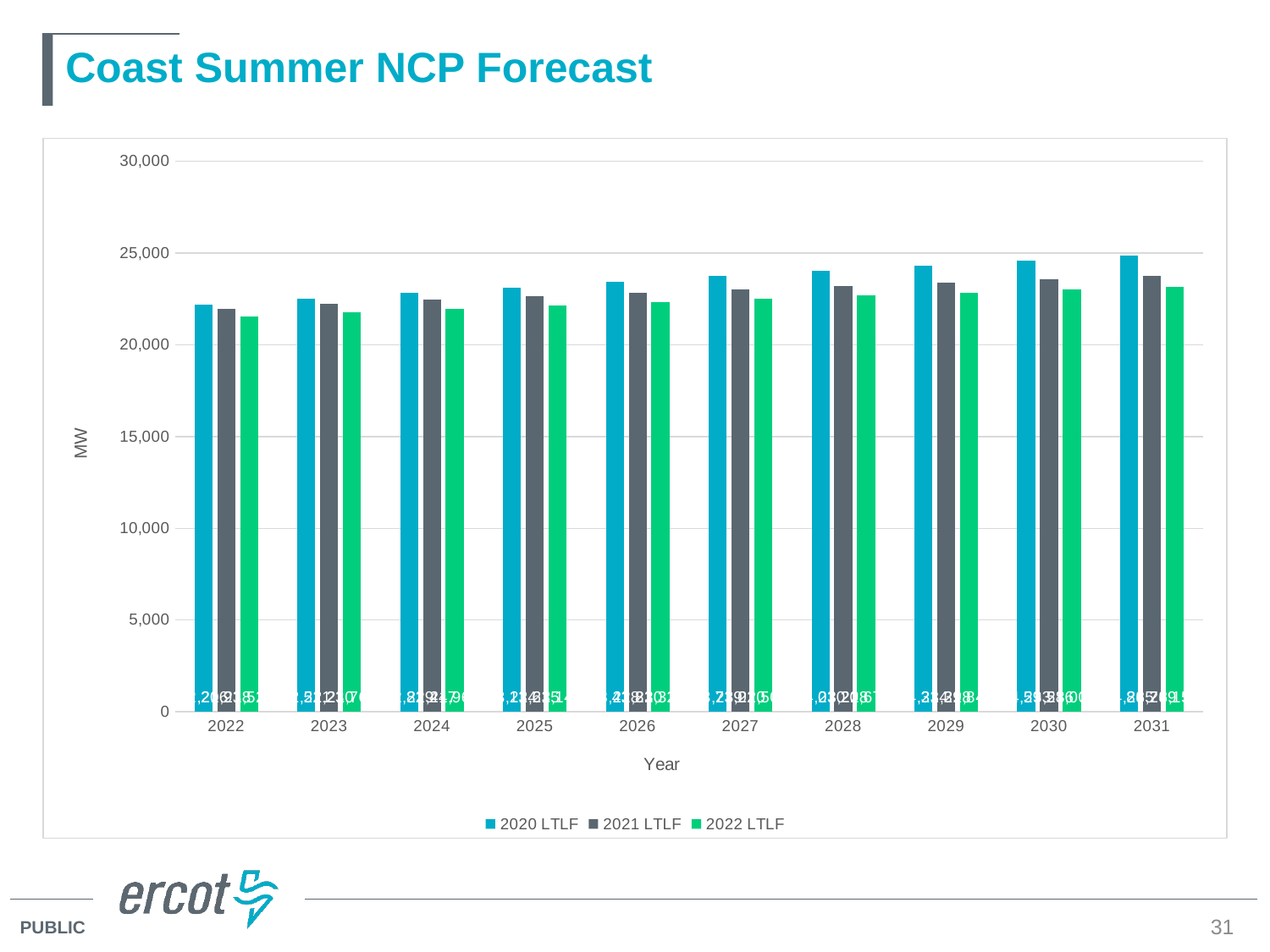
Is the 2022 LTLF value for 2031 greater or less than 25,000? less In 2022, which series has the lowest value? 2022 LTLF Is the 2022 LTLF value for 2022 greater or less than 20,000? greater How many series does the legend list? 3 In 2028, which is larger: the 2020 LTLF value or the 2022 LTLF value? 2020 LTLF In 2031, which series has the highest value? 2020 LTLF What is the label on the y axis? MW What kind of chart is shown on the slide? bar chart Do the 2020 LTLF values rise or fall from 2022 to 2031? rise Which year has the highest 2020 LTLF value? 2031 Which year has the lowest 2022 LTLF value? 2022 How many years are shown on the x axis? 10